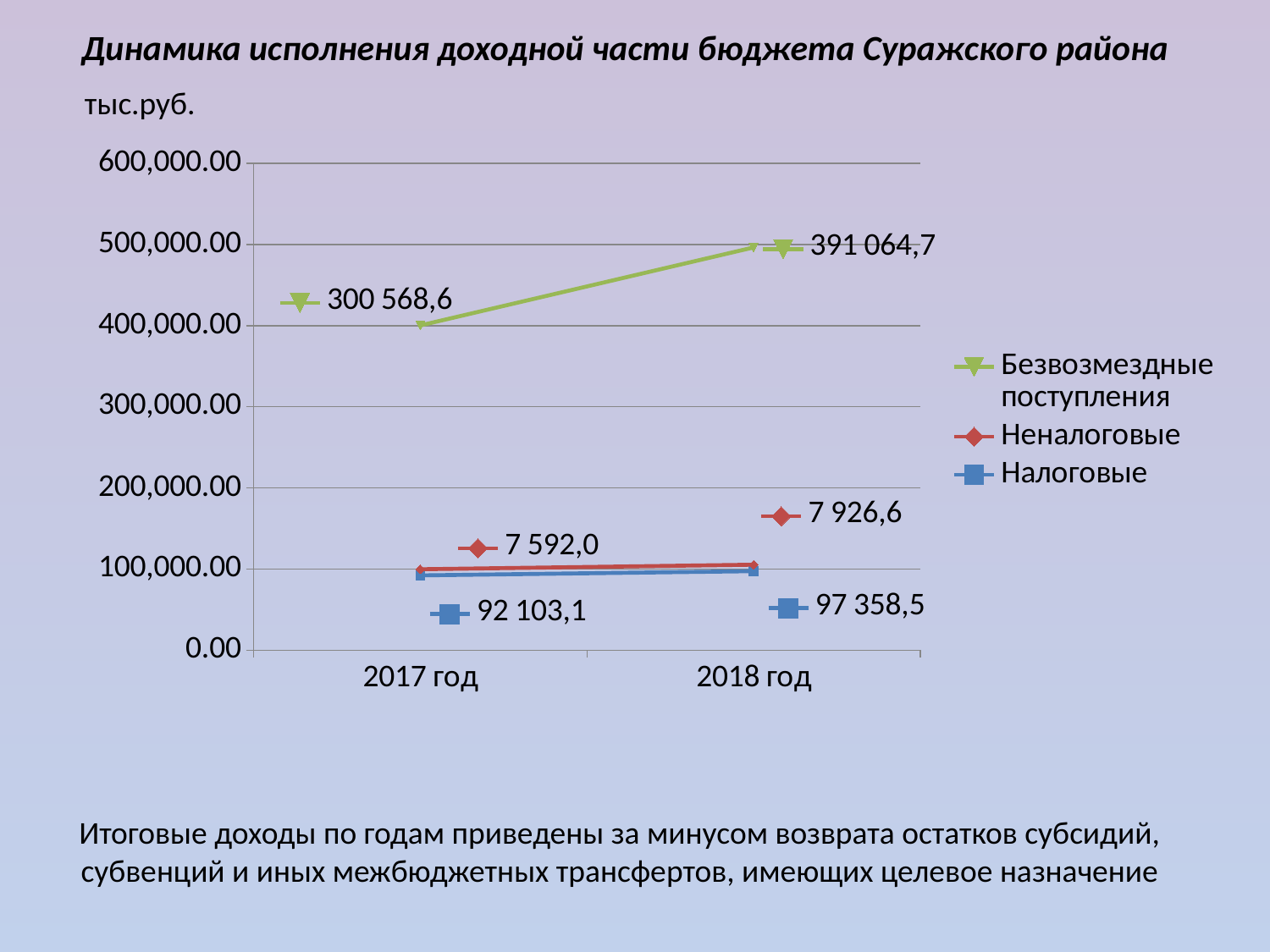
What kind of chart is shown on the slide? line chart What is the value for Безвозмездные поступления in 2017 год? 300 568,6 By how much did Безвозмездные поступления change from 2017 год to 2018 год? 90 496,1 Which is larger in 2017 год: Безвозмездные поступления or Налоговые? Безвозмездные поступления Do the values for Безвозмездные поступления rise or fall from 2017 год to 2018 год? rise How many years are shown on the x axis? 2 What unit of measurement is stated above the chart? тыс.руб. Which series has the highest value in 2018 год? Безвозмездные поступления What is the value for Налоговые in 2017 год? 92 103,1 What is the value for Неналоговые in 2018 год? 7 926,6 How many series does the legend list? 3 What is the value for Безвозмездные поступления in 2018 год? 391 064,7